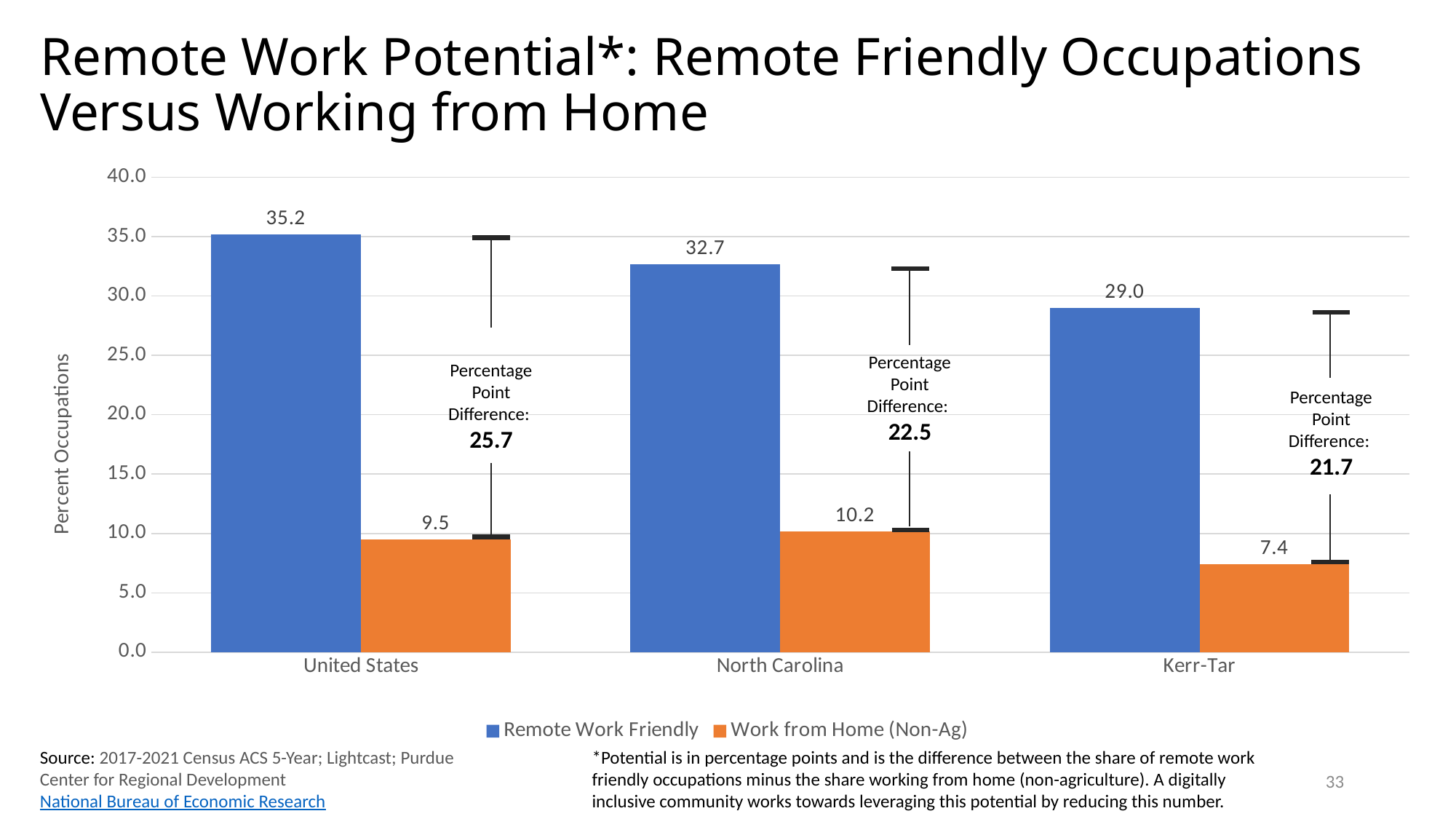
What is the difference between the Remote Work Friendly and Work from Home (Non-Ag) values for North Carolina? 22.5 What is the Work from Home (Non-Ag) value for North Carolina? 10.2 Which region has the highest Remote Work Friendly value? United States Is the Remote Work Friendly value for Kerr-Tar greater or less than 30.0? less How many series does the legend list? 2 What is the Remote Work Friendly value for the United States? 35.2 What is the Work from Home (Non-Ag) value for Kerr-Tar? 7.4 Which region has the lowest Work from Home (Non-Ag) value? Kerr-Tar Which is larger: the Work from Home (Non-Ag) value for the United States or for North Carolina? North Carolina What kind of chart is shown on the slide? bar chart How many regions are shown on the x axis? 3 What is the difference between the Remote Work Friendly values for the United States and Kerr-Tar? 6.2